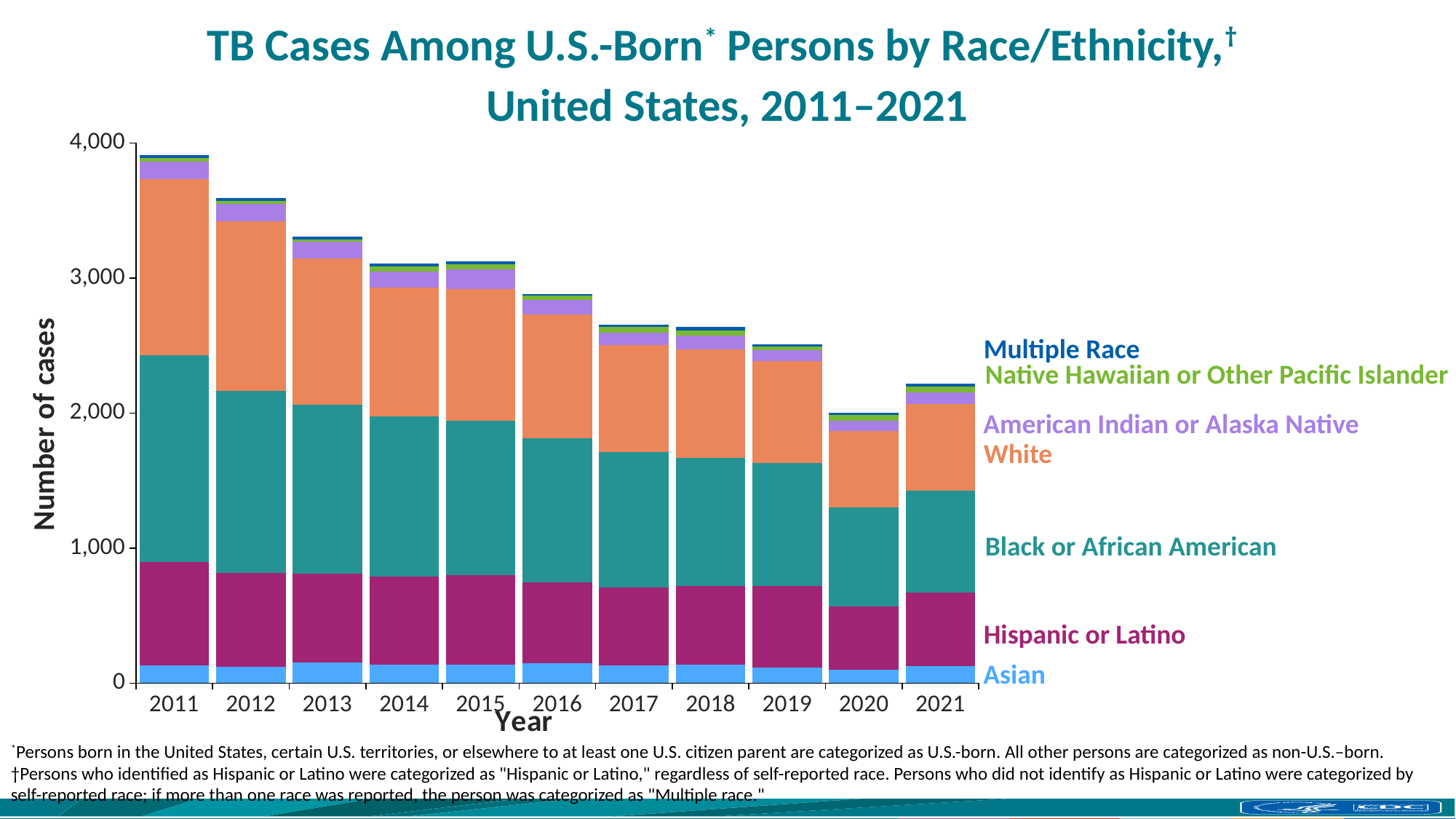
Which year has the highest total number of TB cases among U.S.-born persons? 2011 What kind of chart is shown on the slide? Stacked bar chart What is the label on the y axis of the chart? Number of cases Is the total number of cases in 2011 greater or less than 3,000? greater Which year has the lowest total number of TB cases among U.S.-born persons? 2020 Is the total number of cases in 2016 greater or less than 3,000? less Is the total number of cases in 2020 greater or less than 3,000? less How many years are shown along the x axis of the chart? 11 Overall, do the total TB cases rise or fall from 2011 to 2020? Fall Which year has a larger total number of cases, 2011 or 2021? 2011 How many race/ethnicity groups does the chart's legend list? 7 In 2011, which group accounts for more cases, Black or African American or White? Black or African American